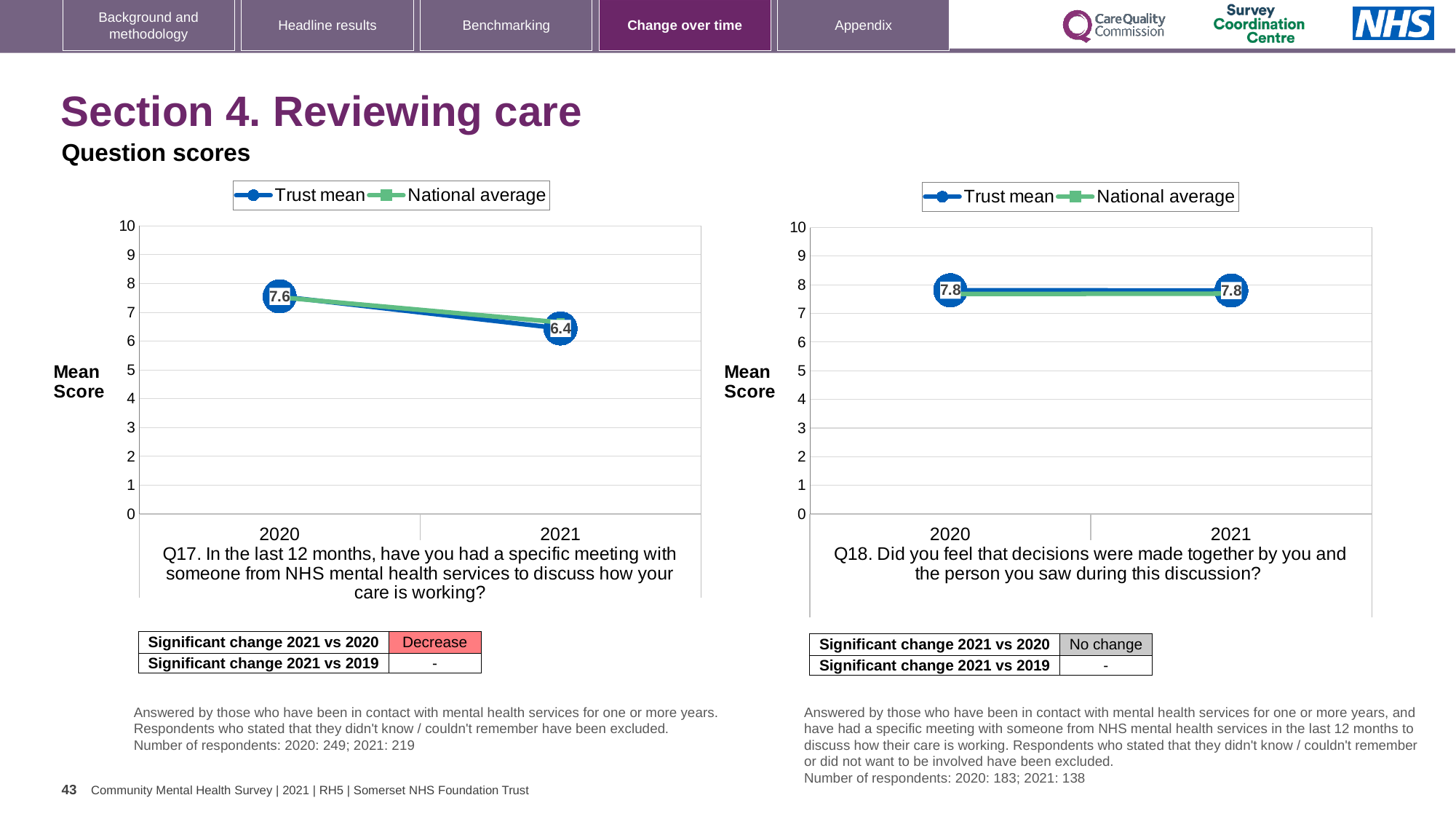
How many series does the legend of the Q17 chart on the left list? 2 Which chart has the higher Trust mean for 2021, the Q17 chart on the left or the Q18 chart on the right? Q18 chart on the right In the Q18 chart on the right, is the Trust mean for 2021 greater or less than 7? greater What kind of chart is the Q18 chart on the right? line chart In the Q18 chart on the right, what is the Trust mean for 2021? 7.8 In the Q17 chart on the left, does the Trust mean rise or fall from 2020 to 2021? fall In the Q17 chart on the left, by how much did the Trust mean fall from 2020 to 2021? 1.2 In the Q17 chart on the left, is the Trust mean for 2021 greater or less than 7? less How many years are plotted on the x axis of the Q18 chart on the right? 2 In the Q18 chart on the right, what is the Trust mean for 2020? 7.8 In the Q17 chart on the left, what is the Trust mean for 2021? 6.4 In the Q17 chart on the left, what is the Trust mean for 2020? 7.6